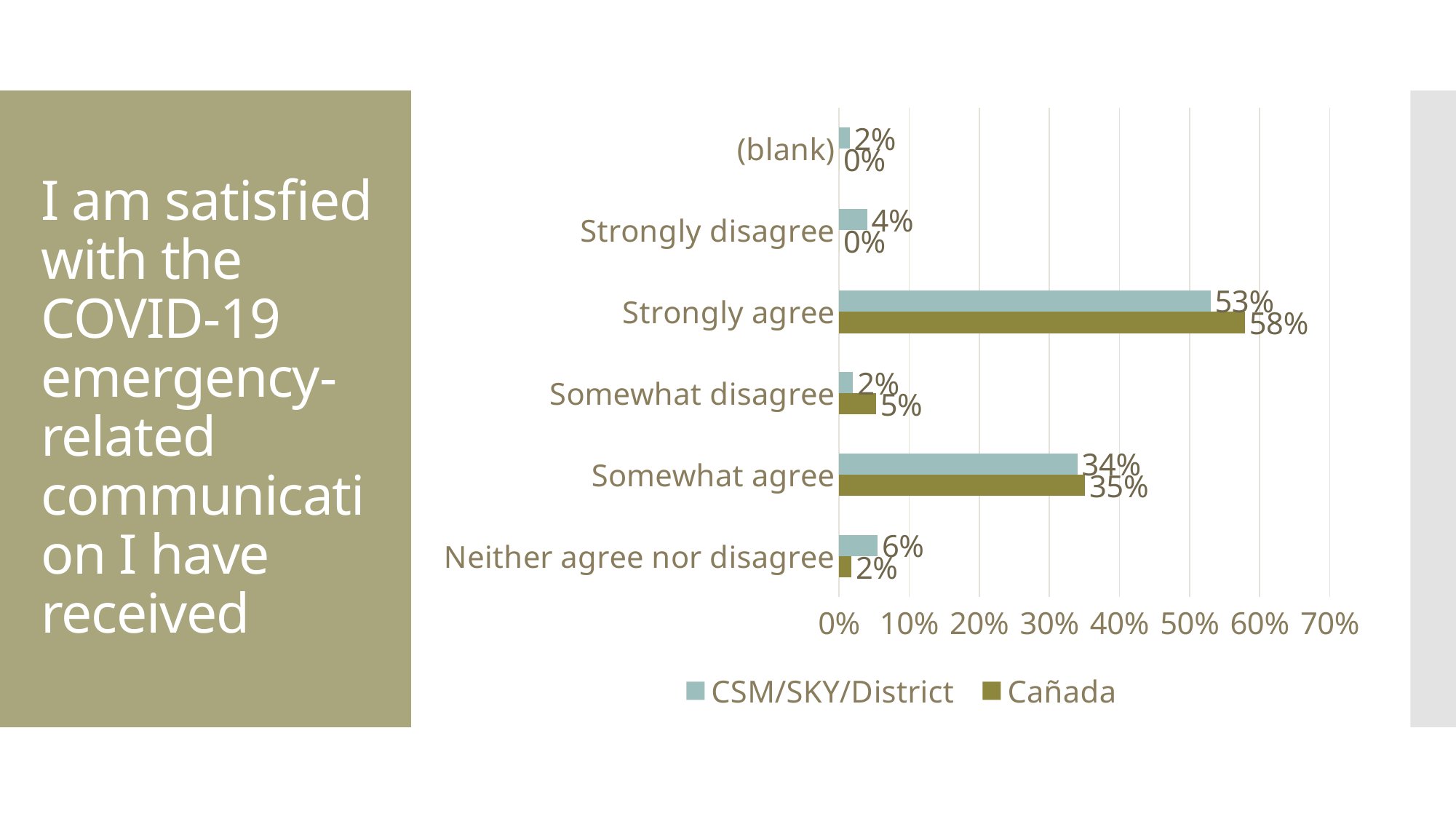
What is the value for Cañada in the Strongly agree category? 58% How many categories are shown on the chart? 6 What is the value for CSM/SKY/District in the Neither agree nor disagree category? 6% What is the value for CSM/SKY/District in the Somewhat agree category? 34% Which is larger in the Neither agree nor disagree category, CSM/SKY/District or Cañada? CSM/SKY/District Which category has the highest value for CSM/SKY/District? Strongly agree What is the value for Cañada in the Strongly disagree category? 0% What is the difference between the Cañada and CSM/SKY/District values for Strongly agree? 5% How many series does the legend list? 2 What kind of chart is shown on the slide? Bar chart Which series is shown in the darker olive colour? Cañada What is the value for Cañada in the Somewhat disagree category? 5%